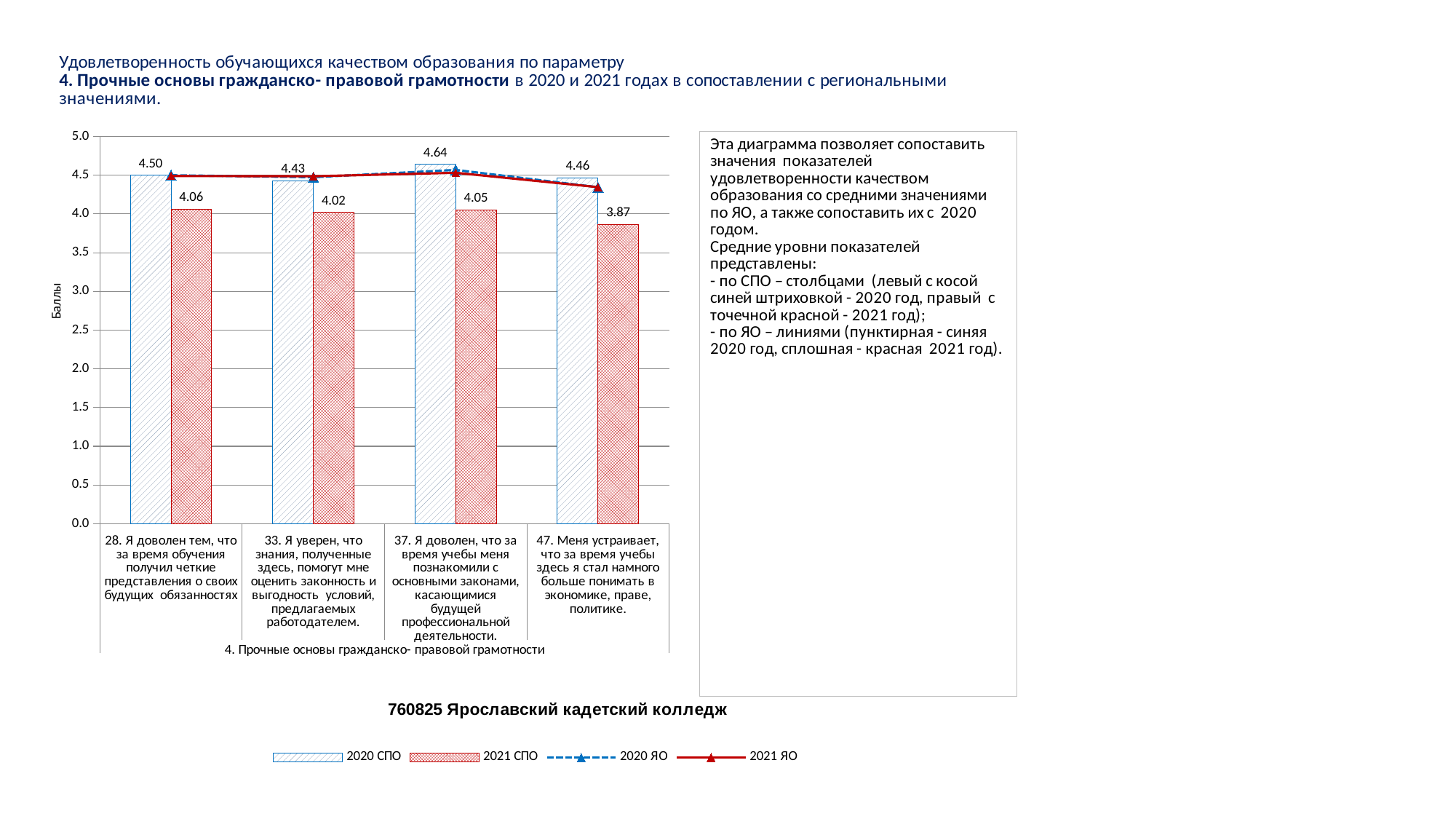
What is the 2020 СПО value for question 28 ("Я доволен тем, что за время обучения получил четкие представления о своих будущих обязанностях")? 4.50 How many series does the chart legend list? 4 What is the label of the y axis of the chart? Баллы How many questions (categories) are shown on the x axis of the chart? 4 What kind of chart is shown on the slide? Combined bar and line chart What is the difference between the 2020 СПО and 2021 СПО values for question 37? 0.59 What is the 2021 СПО value for question 33? 4.02 Which question has the lowest 2021 СПО value? 47. Меня устраивает, что за время учебы здесь я стал намного больше понимать в экономике, праве, политике. What is the 2021 СПО value for question 47 ("Меня устраивает, что за время учебы здесь я стал намного больше понимать в экономике, праве, политике")? 3.87 Is the 2021 ЯО value for question 47 greater or less than 4.5? less Which question has the highest 2020 СПО value? 37. Я доволен, что за время учебы меня познакомили с основными законами, касающимися будущей профессиональной деятельности. Which is larger for question 28: the 2020 СПО value or the 2021 СПО value? 2020 СПО